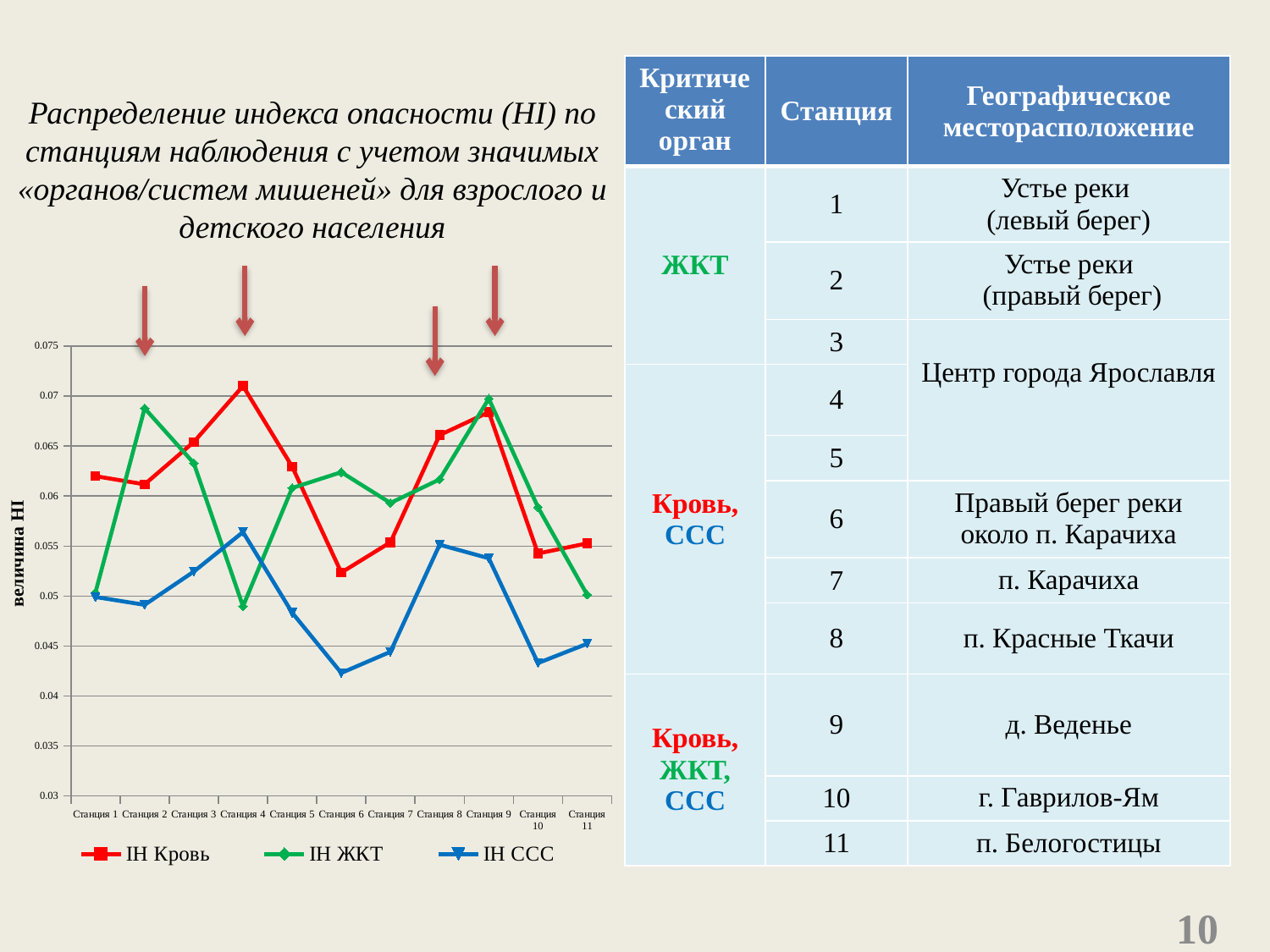
How many stations are plotted along the x axis of the chart? 11 How many series does the chart legend list? 3 At Станция 4, which series has the larger value, IH Кровь or IH ЖКТ? IH Кровь At which station does the IH ССС series reach its lowest value? Станция 6 Does the IH ССС series rise or fall from Станция 4 to Станция 6? fall Is the IH ССС value at Станция 6 greater or less than 0.045? less Is the IH ЖКТ value at Станция 2 greater or less than 0.065? greater At which station does the IH Кровь series reach its highest value? Станция 4 What kind of chart is shown on the slide? line chart Is the IH Кровь value at Станция 6 greater or less than 0.055? less What is the label on the y axis of the chart? величина HI At which station does the IH Кровь series reach its lowest value? Станция 6